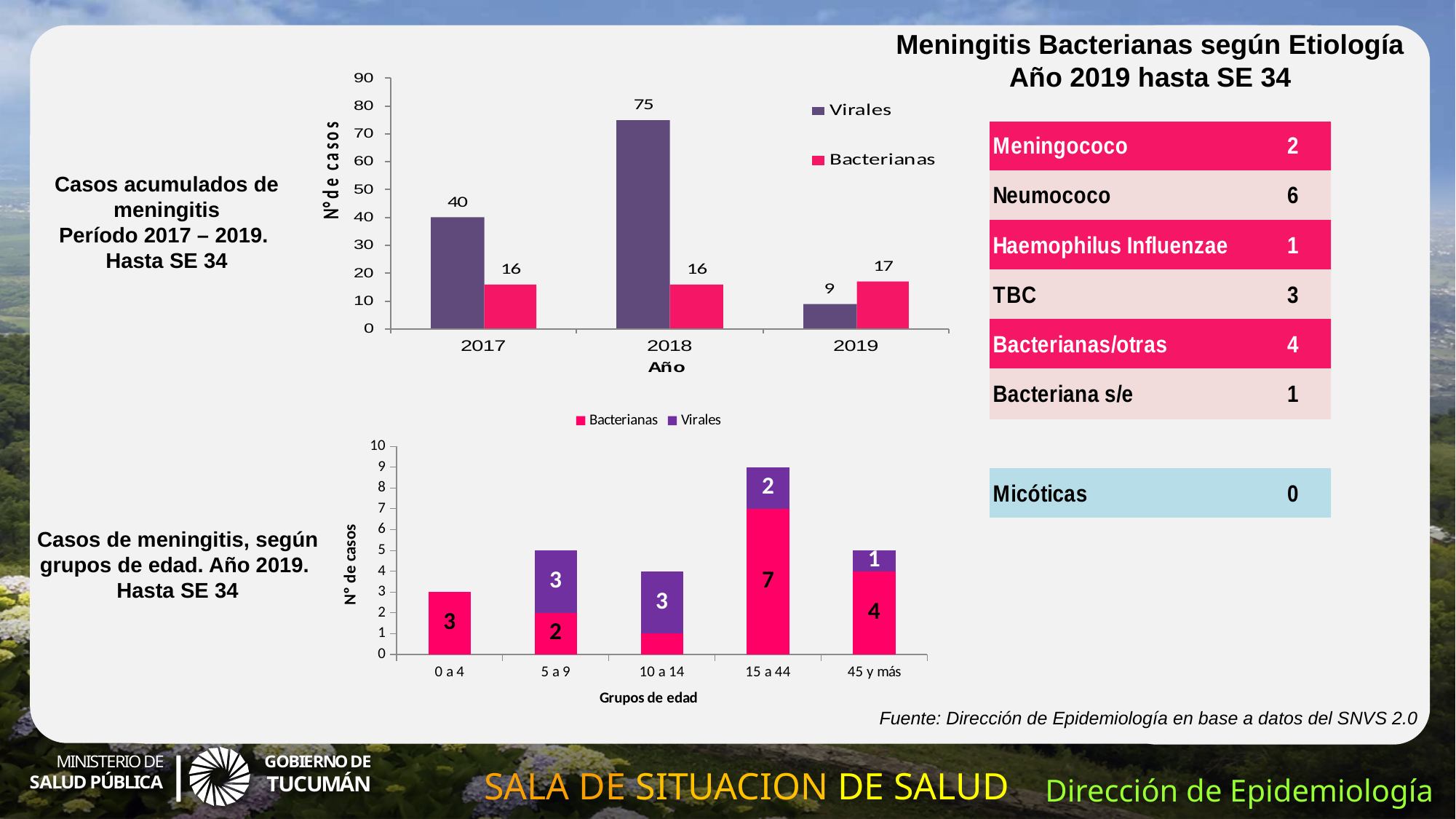
In the bottom chart (Casos de meningitis, según grupos de edad, Año 2019), what is the total number of cases in the 5 a 9 age group? 5 In the bottom chart (Casos de meningitis, según grupos de edad, Año 2019), how many age groups are shown on the x axis? 5 In the top chart (Casos acumulados de meningitis, Período 2017 – 2019), how many Virales cases were there in 2018? 75 In the top chart (Casos acumulados de meningitis, Período 2017 – 2019), in 2019, which series has more cases, Virales or Bacterianas? Bacterianas In the top chart (Casos acumulados de meningitis, Período 2017 – 2019), what is the difference between Virales and Bacterianas cases in 2017? 24 In the bottom chart (Casos de meningitis, según grupos de edad, Año 2019), how many Bacterianas cases are in the 15 a 44 age group? 7 In the bottom chart (Casos de meningitis, según grupos de edad, Año 2019), what is the total number of cases in the 15 a 44 age group? 9 In the top chart (Casos acumulados de meningitis, Período 2017 – 2019), do the Virales cases rise or fall from 2018 to 2019? fall In the top chart (Casos acumulados de meningitis, Período 2017 – 2019), how many series does the legend list? 2 In the top chart (Casos acumulados de meningitis, Período 2017 – 2019), which year has the highest number of Virales cases? 2018 In the top chart (Casos acumulados de meningitis, Período 2017 – 2019), how many Bacterianas cases were there in 2019? 17 What type of chart is the bottom chart (Casos de meningitis, según grupos de edad, Año 2019)? stacked bar chart